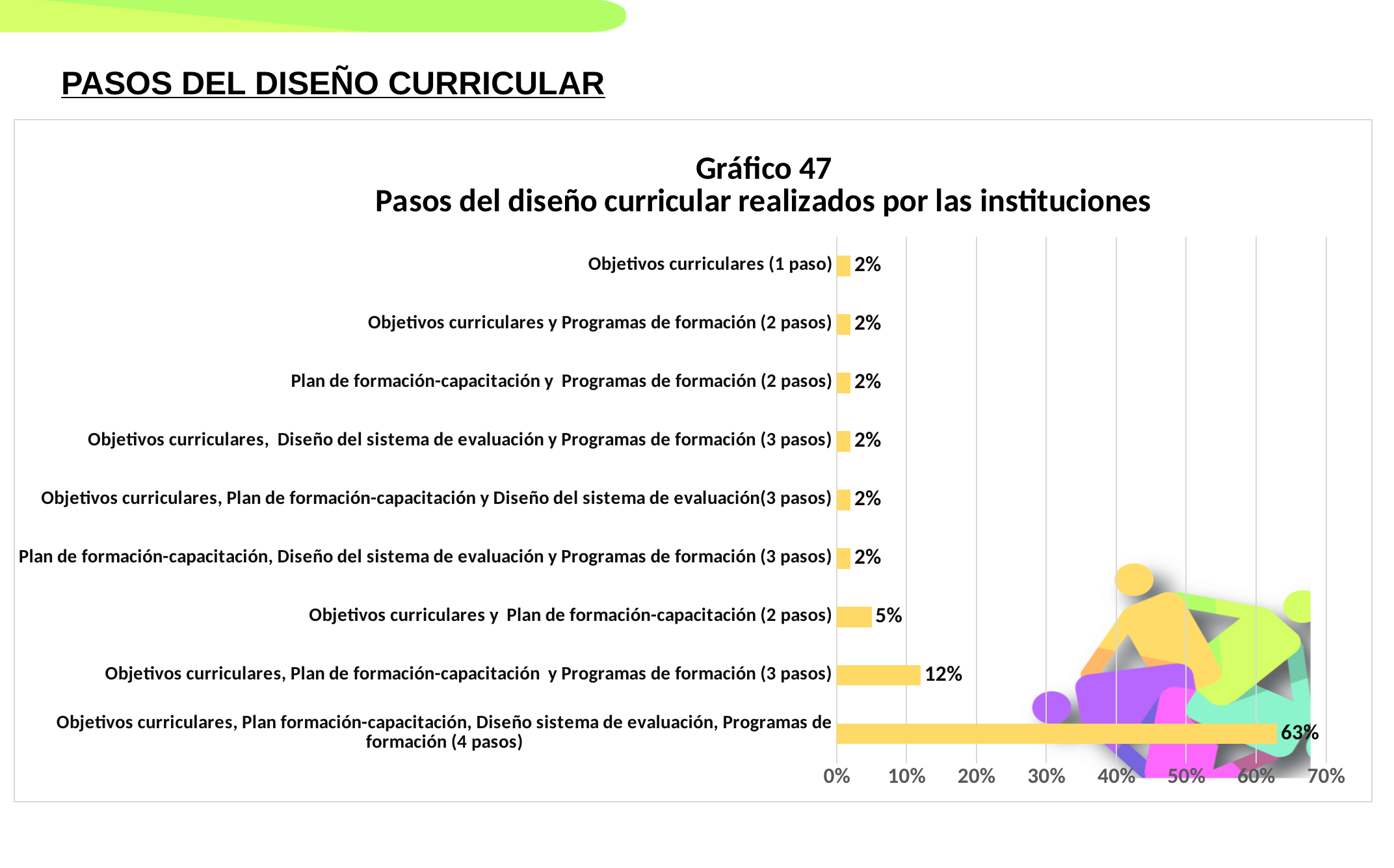
What kind of chart is shown on the slide? bar chart What is the value for 'Objetivos curriculares y Plan de formación-capacitación (2 pasos)'? 5% Which category has the highest value? Objetivos curriculares, Plan formación-capacitación, Diseño sistema de evaluación, Programas de formación (4 pasos) What is the value for 'Objetivos curriculares, Plan formación-capacitación, Diseño sistema de evaluación, Programas de formación (4 pasos)'? 63% Which is larger: the value for 'Objetivos curriculares y Plan de formación-capacitación (2 pasos)' or the value for 'Objetivos curriculares (1 paso)'? Objetivos curriculares y Plan de formación-capacitación (2 pasos) Is the value for the 4 pasos category greater or less than 60%? greater What is the difference between the value for the 4 pasos category and the value for 'Objetivos curriculares, Plan de formación-capacitación y Programas de formación (3 pasos)'? 51% What is the title of the chart? Gráfico 47 Pasos del diseño curricular realizados por las instituciones How many categories are shown in the chart? 9 What is the difference between the value for 'Objetivos curriculares, Plan de formación-capacitación y Programas de formación (3 pasos)' and the value for 'Objetivos curriculares y Plan de formación-capacitación (2 pasos)'? 7% What is the value for 'Objetivos curriculares (1 paso)'? 2% What is the value for 'Objetivos curriculares, Plan de formación-capacitación y Programas de formación (3 pasos)'? 12%